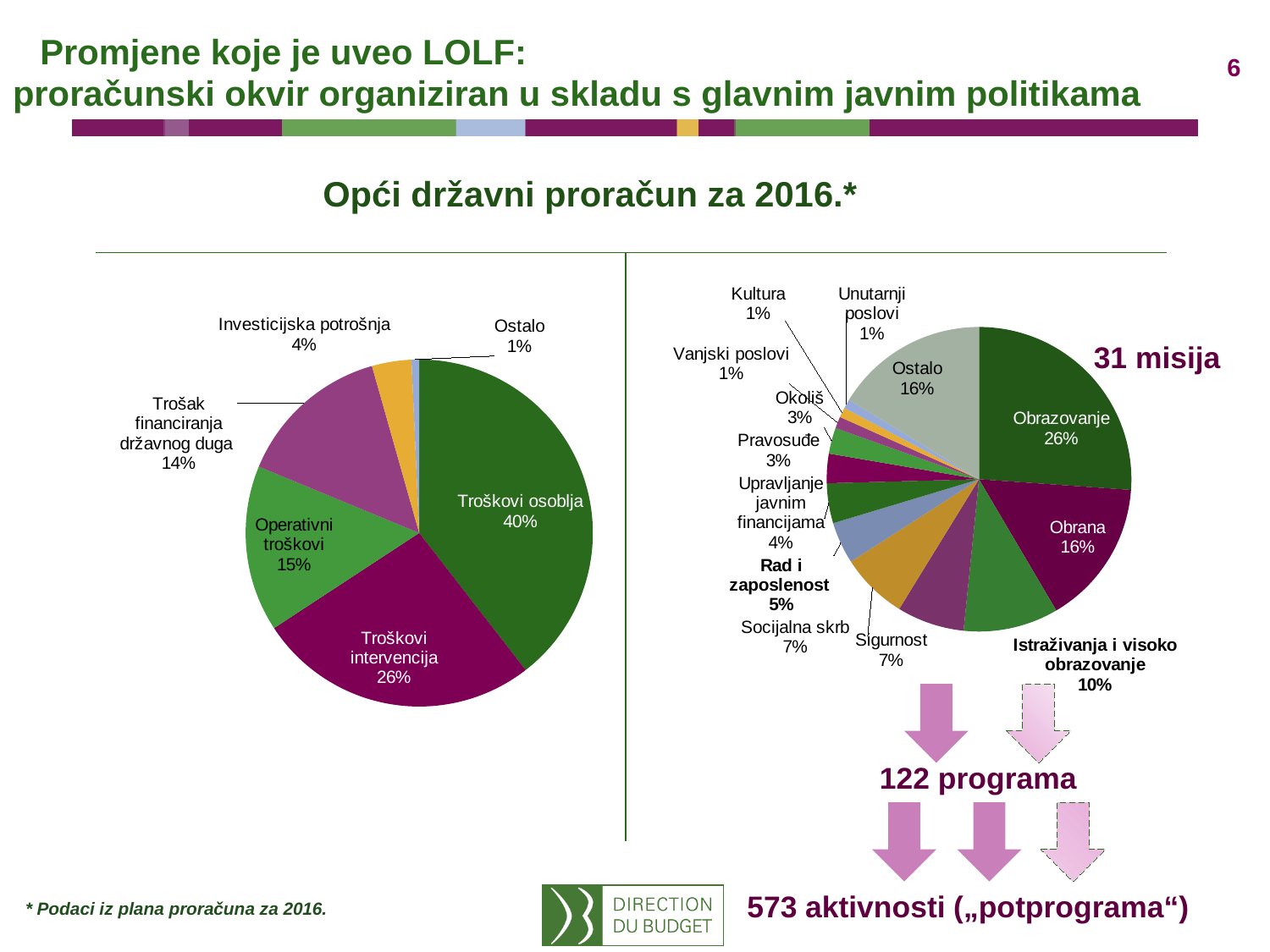
In the left pie chart, what is the difference in percentage points between Troškovi intervencija and Operativni troškovi? 11 What type of chart is shown on the left side of the slide? Pie chart How many slices does the left pie chart have? 6 In the right pie chart, what share is labelled for Obrazovanje? 26% In the left pie chart, which category has the largest share? Troškovi osoblja In the left pie chart, what share is labelled for Troškovi osoblja? 40% In the right pie chart, which category has the largest share? Obrazovanje In the right pie chart, what share is labelled for Istraživanja i visoko obrazovanje? 10% How many slices does the right pie chart have? 13 In the right pie chart, which is larger, Socijalna skrb or Rad i zaposlenost? Socijalna skrb In the left pie chart, what share is labelled for Trošak financiranja državnog duga? 14% In the left pie chart, which category has the smallest share? Ostalo